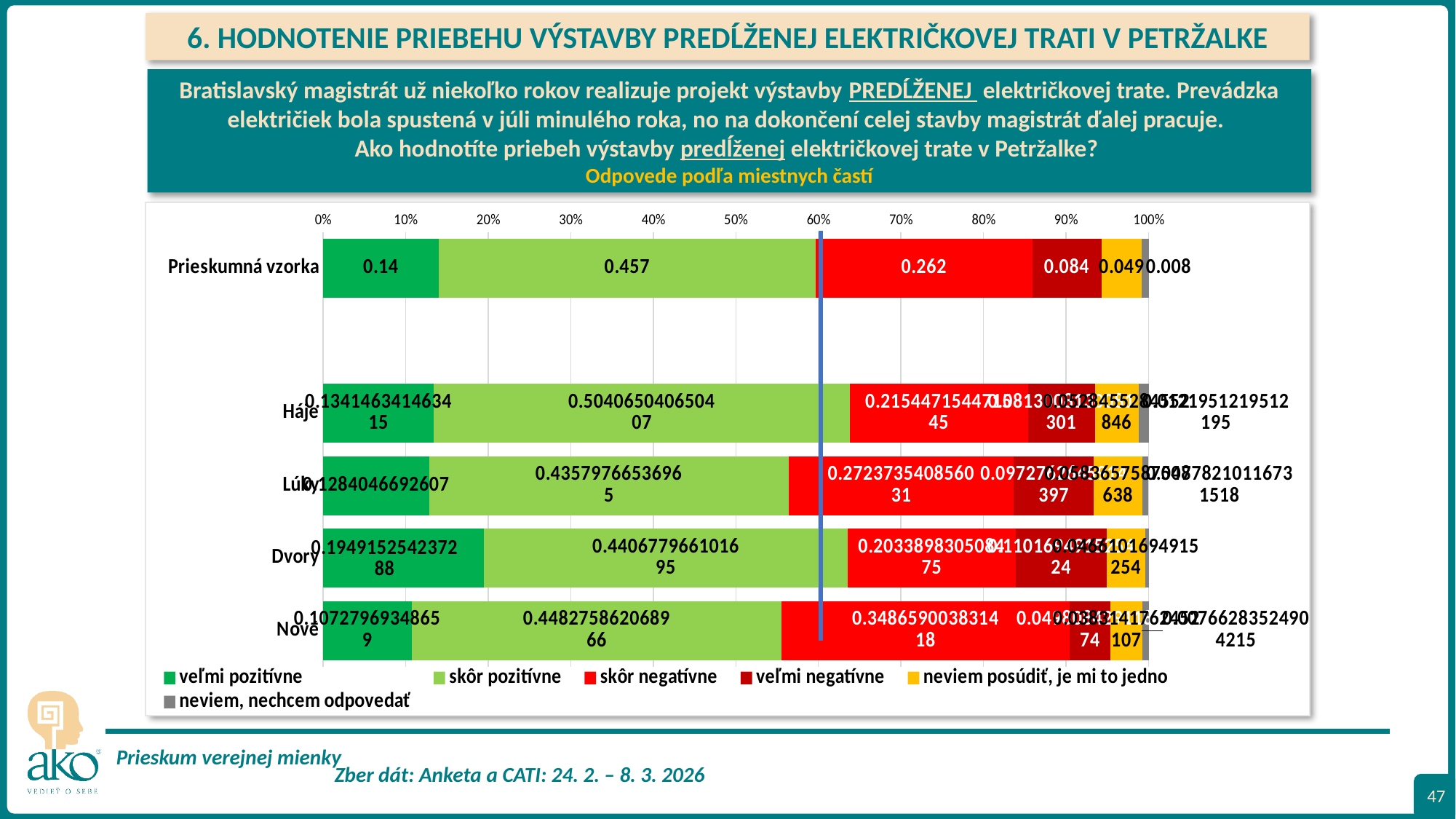
What is the value of 'veľmi negatívne' for Prieskumná vzorka? 0.084 What is the value of 'skôr pozitívne' for Prieskumná vzorka? 0.457 Among the local parts Háje, Lúky, Dvory and Nové, which has the highest 'skôr negatívne' value? Nové Which has the larger 'veľmi pozitívne' value, Dvory or Nové? Dvory For Prieskumná vzorka, what is the difference between the 'skôr pozitívne' and 'veľmi pozitívne' values? 0.317 What is the value of 'skôr negatívne' for Prieskumná vzorka? 0.262 How many series does the legend list? 6 How many categories (rows) are plotted in the chart? 5 What is the value of 'veľmi pozitívne' for Prieskumná vzorka? 0.14 What is the value of 'neviem, nechcem odpovedať' for Prieskumná vzorka? 0.008 What kind of chart is shown on the slide? Stacked bar chart Which colour represents 'skôr negatívne' in the chart? Red